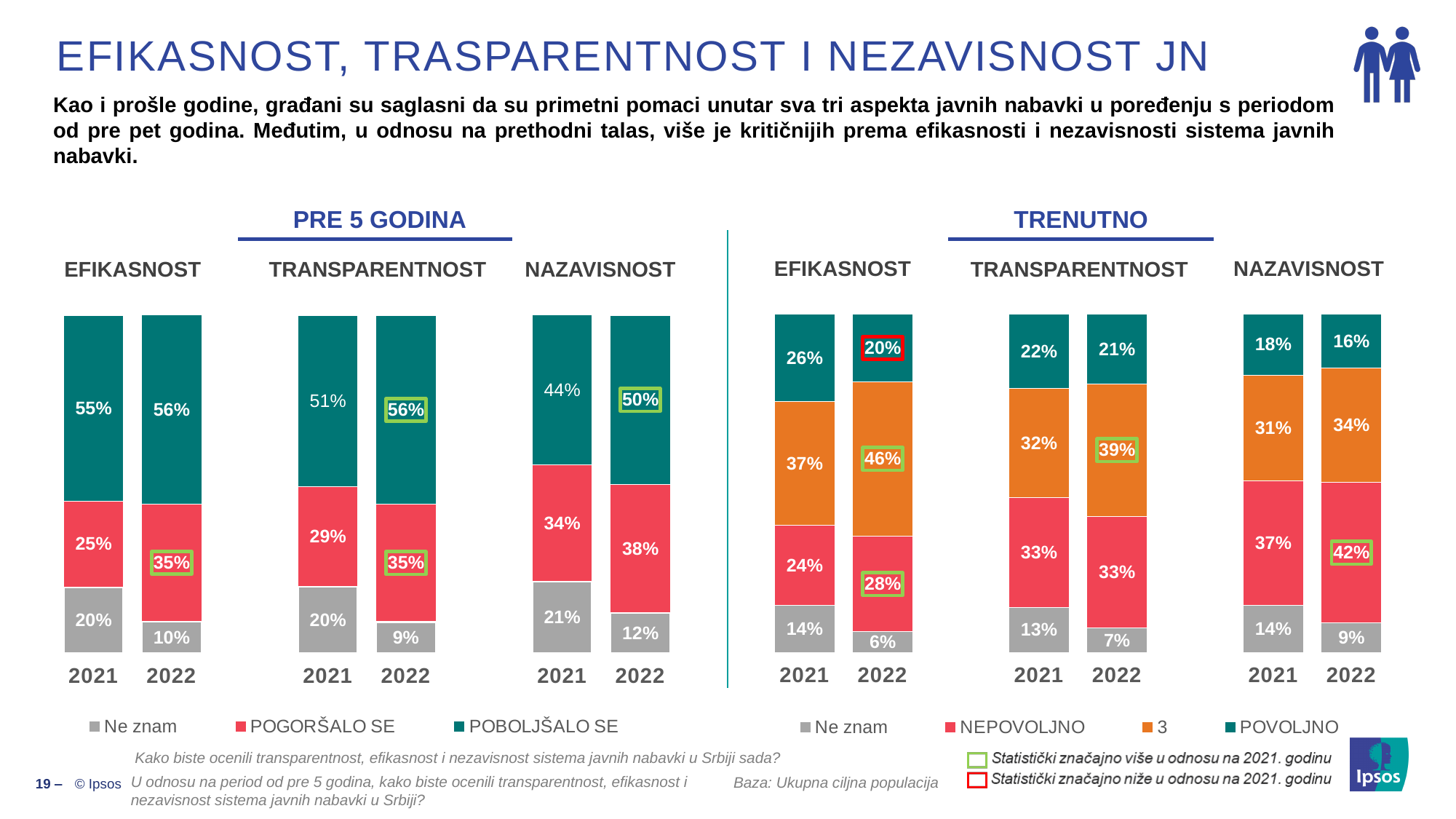
In the TRENUTNO NAZAVISNOST chart, which segment is the smallest in the 2022 bar? Ne znam (9%) In the PRE 5 GODINA NAZAVISNOST chart, which year has the larger POBOLJŠALO SE value, 2021 or 2022? 2022 In the TRENUTNO EFIKASNOST chart, what is the difference between the POVOLJNO values for 2021 and 2022? 6 percentage points In the TRENUTNO NAZAVISNOST chart, what is the value for NEPOVOLJNO in 2022? 42% In the TRENUTNO EFIKASNOST chart, what is the value for the series '3' in 2022? 46% In the PRE 5 GODINA TRANSPARENTNOST chart, what is the value for Ne znam in 2021? 20% In the TRENUTNO TRANSPARENTNOST chart, what is the value for POVOLJNO in 2021? 22% In the TRENUTNO TRANSPARENTNOST chart, what is the total of the 2022 bar (Ne znam + NEPOVOLJNO + 3 + POVOLJNO)? 100% In the PRE 5 GODINA NAZAVISNOST chart, what is the value for POGORŠALO SE in 2022? 38% In the PRE 5 GODINA EFIKASNOST chart, what is the value for POBOLJŠALO SE in 2022? 56% What kind of chart is used on this slide? Stacked bar chart How many series does the legend list for the TRENUTNO charts? 4